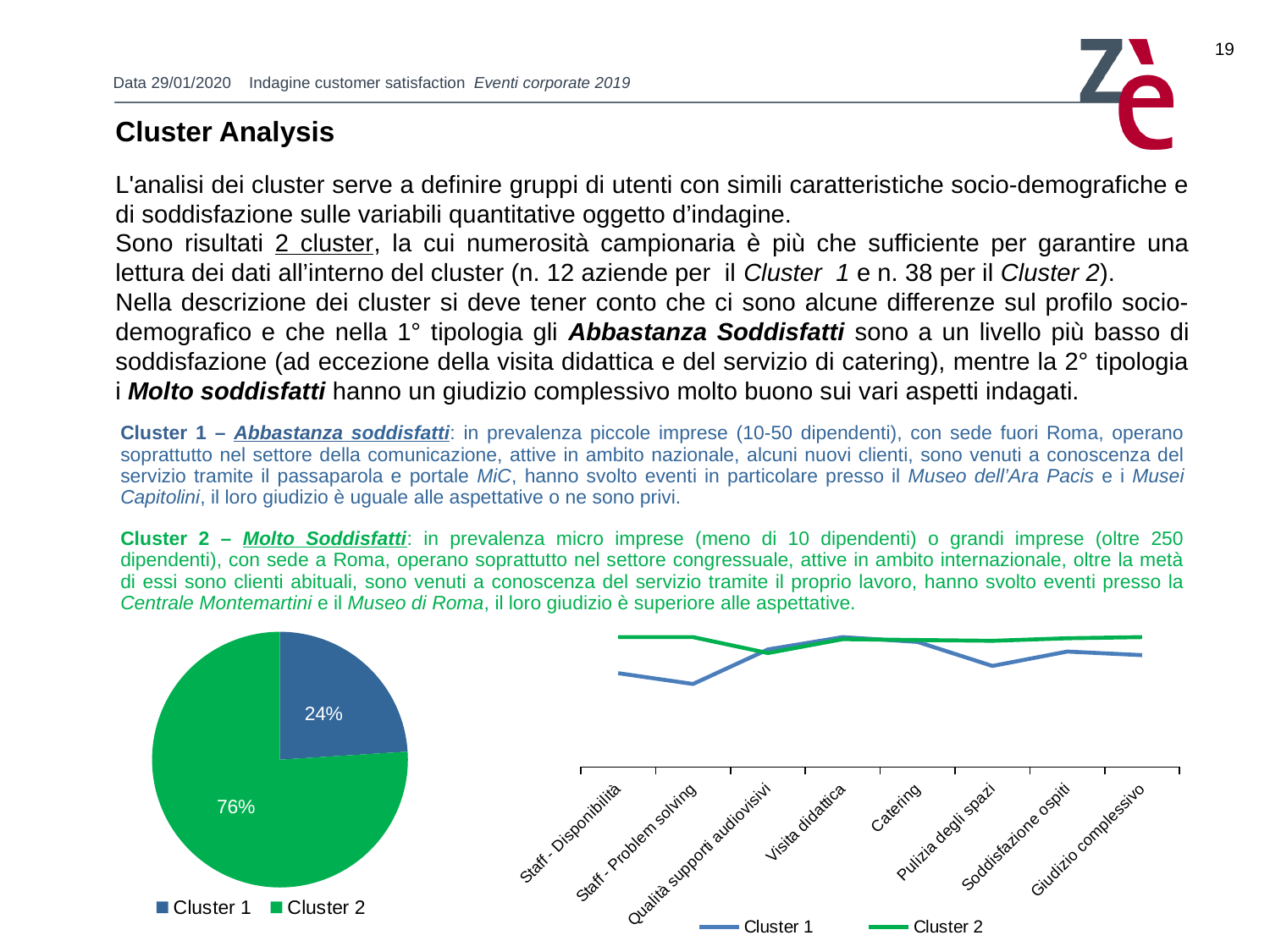
In the line chart on the right, at Staff - Disponibilità, which series has the higher value, Cluster 1 or Cluster 2? Cluster 2 In the pie chart on the left, what is the difference in percentage points between the Cluster 2 and Cluster 1 slices? 52% What kind of chart is the chart on the right of the slide? Line chart How many categories are shown on the x axis of the line chart on the right? 8 What kind of chart is the chart on the left of the slide? Pie chart In the line chart on the right, which category has the lowest value for Cluster 1? Staff - Problem solving How many slices does the pie chart on the left have? 2 In the line chart on the right, does the Cluster 1 line rise or fall from Staff - Problem solving to Visita didattica? Rise How many series does the legend of the line chart on the right list? 2 In the pie chart on the left, what share is shown for Cluster 2? 76% In the pie chart on the left, which cluster has the larger slice? Cluster 2 In the pie chart on the left, what share is shown for Cluster 1? 24%